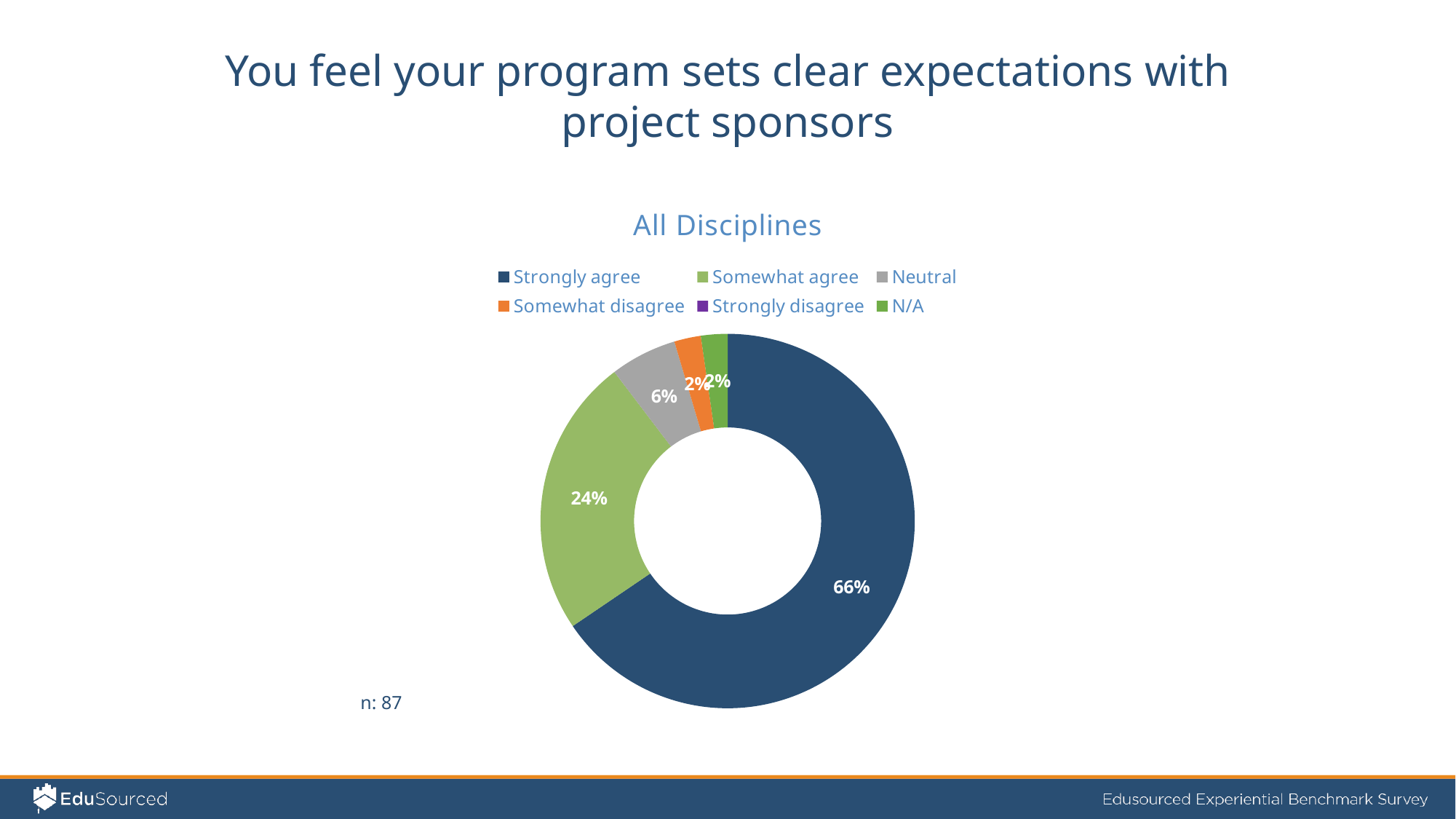
What percentage of respondents chose "Neutral"? 6% What is the difference in percentage points between "Strongly agree" and "Somewhat agree"? 42 percentage points What percentage of respondents chose "Somewhat agree"? 24% How many response categories does the legend list? 6 What percentage of respondents chose "Strongly agree"? 66% Which is larger, the share for "Somewhat agree" or the share for "Neutral"? Somewhat agree What percentage of respondents chose "Somewhat disagree"? 2% What is the combined share of "Strongly agree" and "Somewhat agree"? 90% What is the title shown directly above the chart? All Disciplines Which response category has the largest share of the chart? Strongly agree What kind of chart is shown on the slide? Pie (donut) chart What sample size (n) is shown on the slide? 87